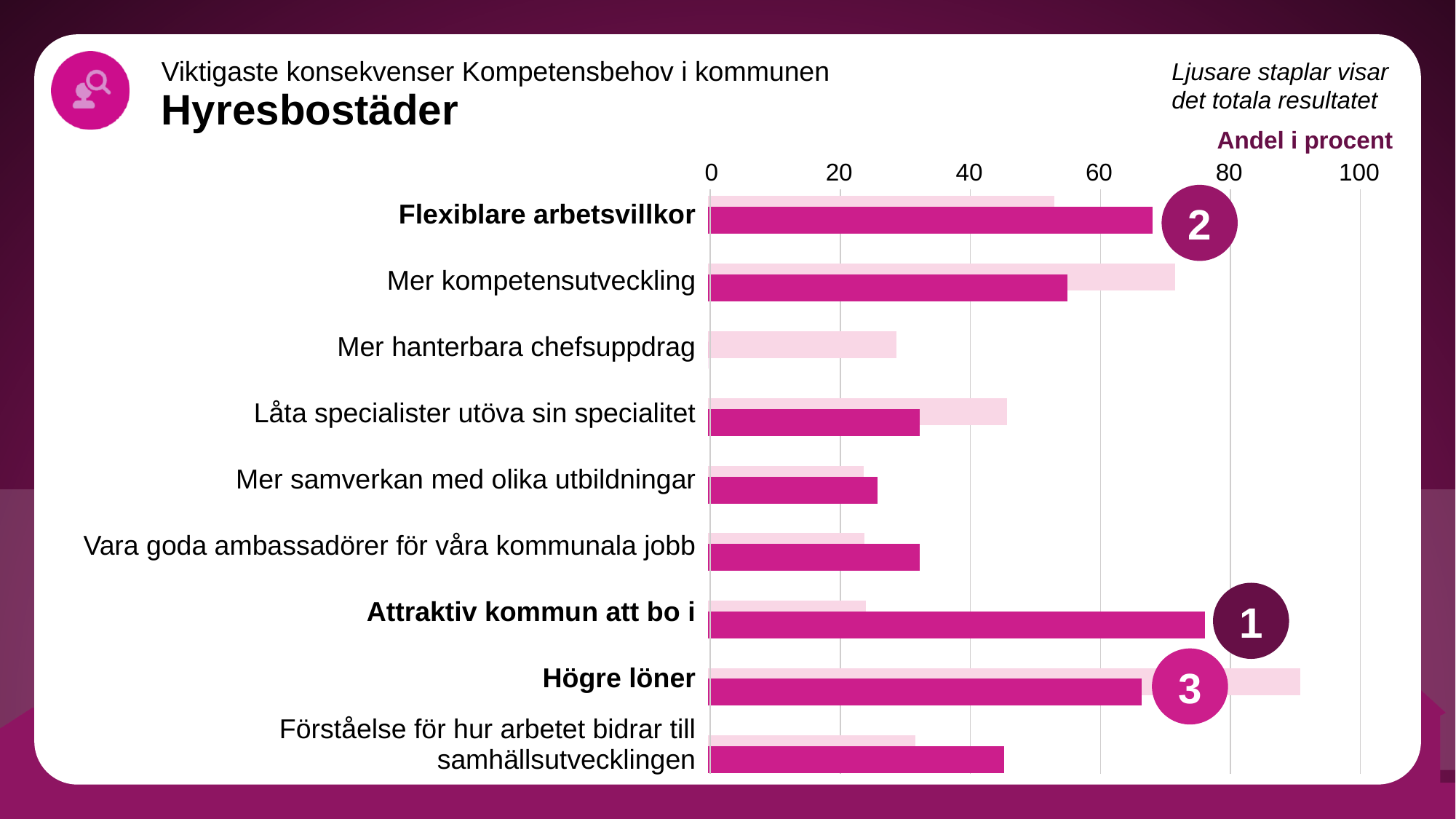
Which category has the highest value for the dark (Hyresbostäder) bars? Attraktiv kommun att bo i Is the light bar value for Högre löner greater or less than 80? greater Is the light bar value for Mer hanterbara chefsuppdrag greater or less than 40? less How many categories are listed on the chart? 9 Is the dark bar value for Mer samverkan med olika utbildningar greater or less than 40? less According to the note on the slide, what do the lighter bars show? det totala resultatet For Högre löner, which bar is larger: the light bar or the dark bar? the light bar Which has the larger dark bar value: Flexiblare arbetsvillkor or Mer kompetensutveckling? Flexiblare arbetsvillkor What kind of chart is shown on the slide? bar chart What unit label is shown above the x axis? Andel i procent For Förståelse för hur arbetet bidrar till samhällsutvecklingen, which bar is larger: the dark bar or the light bar? the dark bar